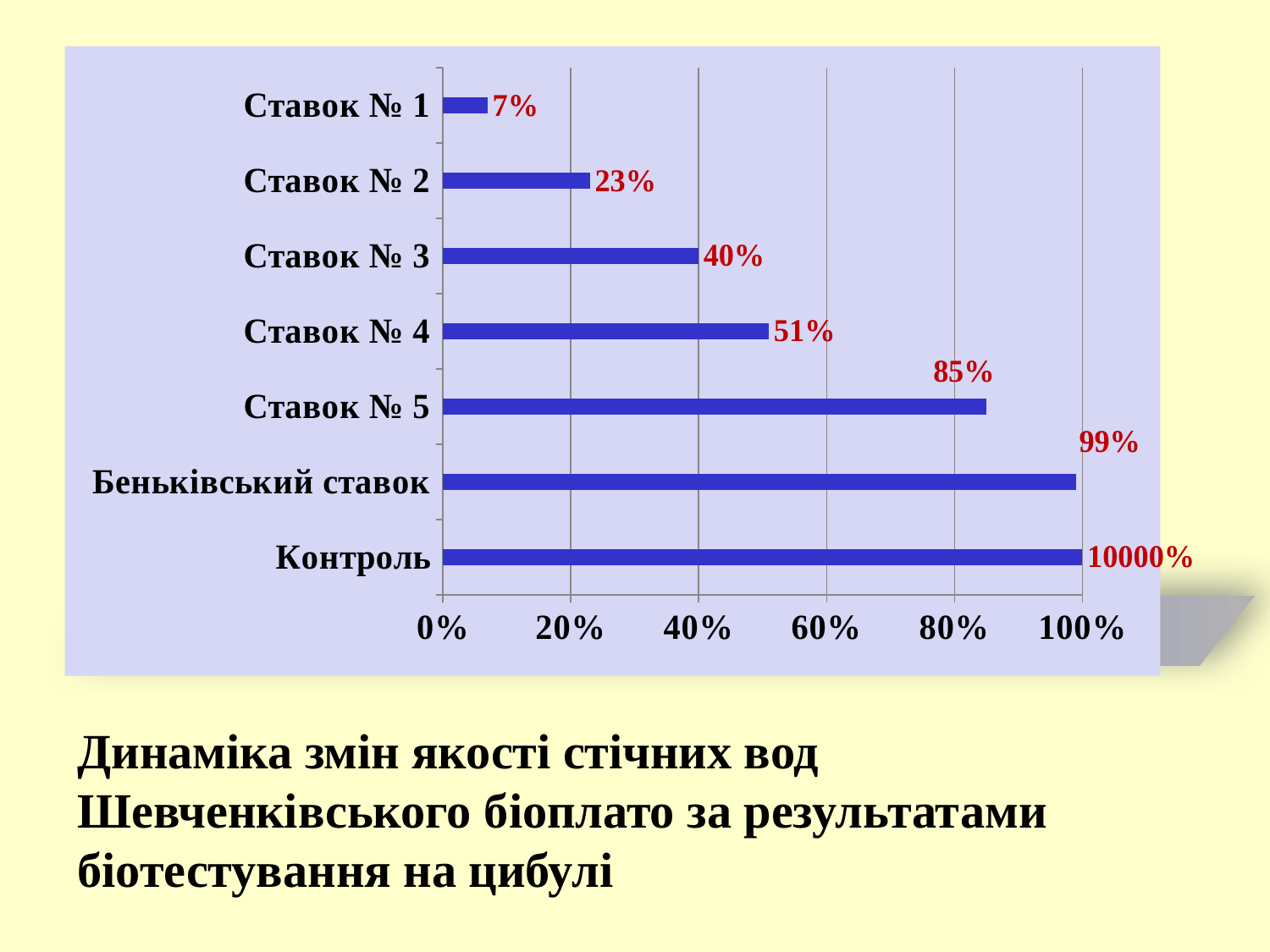
What is the value for Ставок № 5? 85% Is the value for Ставок № 2 greater or less than 40%? less Which category has the lowest value? Ставок № 1 What is the difference between the values for Ставок № 4 and Ставок № 2? 28% Which category has the longest bar? Контроль How many categories are plotted in the chart? 7 What is the value for Ставок № 3? 40% Which is larger, the value for Ставок № 5 or the value for Ставок № 4? Ставок № 5 What type of chart is shown on the slide? bar chart Do the values rise or fall going down the list from Ставок № 1 to Контроль? rise What is the value for Беньківський ставок? 99% What is the value for Ставок № 1? 7%